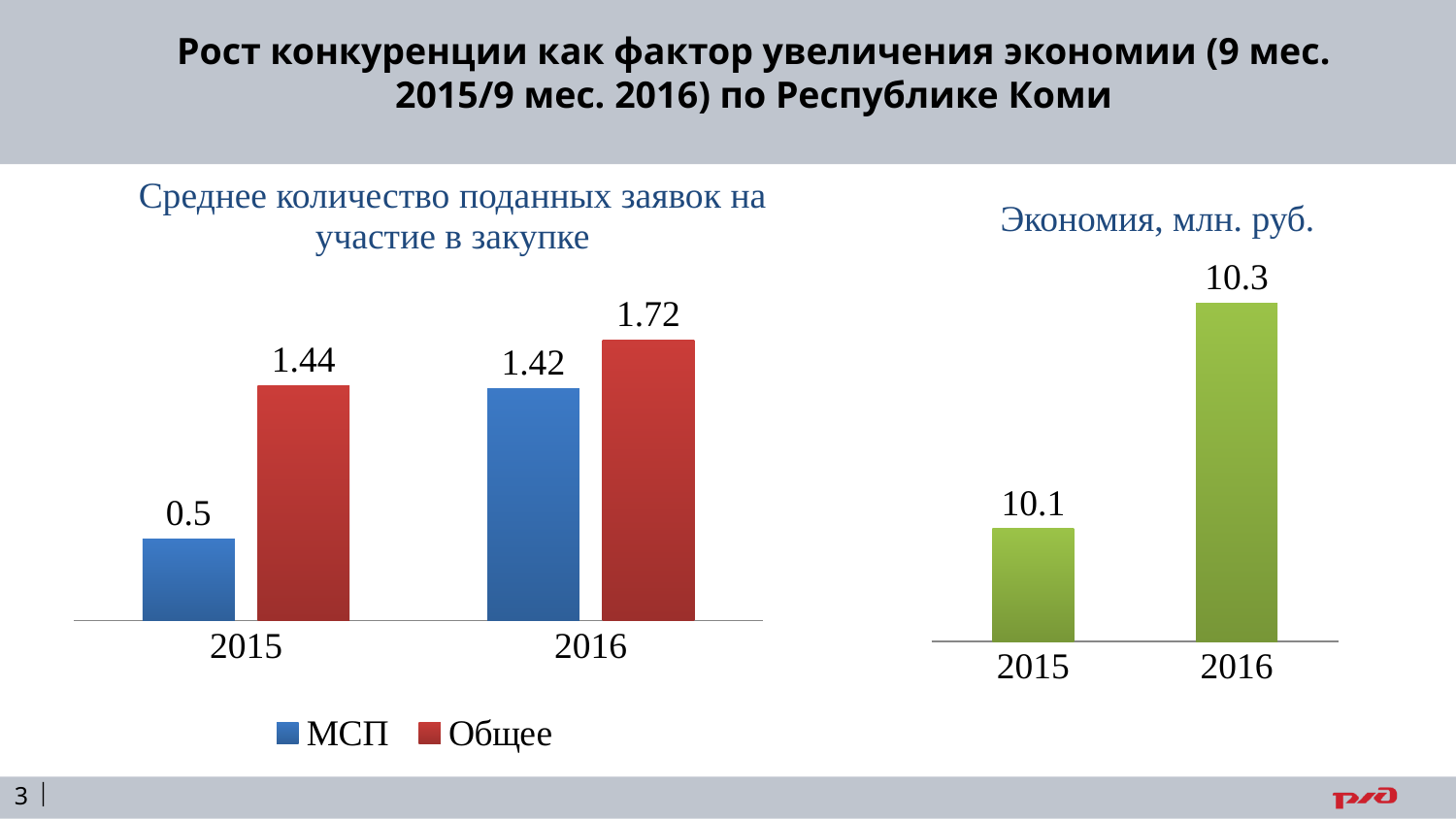
In the left chart (Среднее количество поданных заявок на участие в закупке), what is the value for МСП in 2015? 0.5 In the left chart (Среднее количество поданных заявок на участие в закупке), which series has the larger value in 2015, МСП or Общее? Общее What kind of chart is the right chart (Экономия, млн. руб.)? Bar chart How many series does the legend of the left chart (Среднее количество поданных заявок на участие в закупке) list? 2 In the right chart (Экономия, млн. руб.), do the values rise or fall from 2015 to 2016? Rise In the left chart (Среднее количество поданных заявок на участие в закупке), what is the difference between the МСП values for 2016 and 2015? 0.92 In the left chart (Среднее количество поданных заявок на участие в закупке), what is the difference between the Общее values for 2016 and 2015? 0.28 In the right chart (Экономия, млн. руб.), which year has the higher value? 2016 In the right chart (Экономия, млн. руб.), what is the value for 2016? 10.3 In the left chart (Среднее количество поданных заявок на участие в закупке), what is the value for МСП in 2016? 1.42 In the left chart (Среднее количество поданных заявок на участие в закупке), what is the value for Общее in 2016? 1.72 In the right chart (Экономия, млн. руб.), what is the value for 2015? 10.1